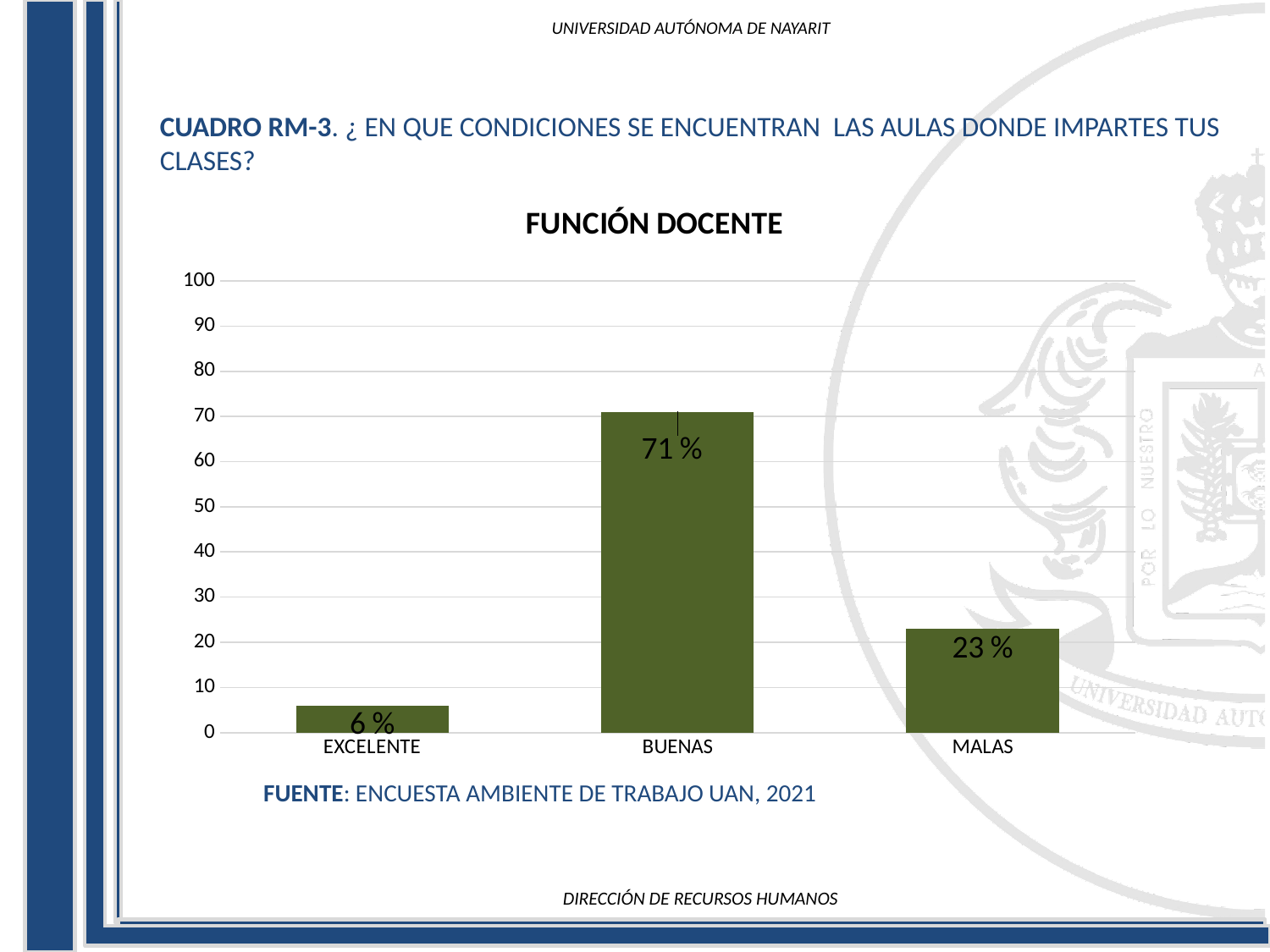
Is the value for BUENAS greater or less than 50? greater What is the difference between the values for BUENAS and MALAS? 48 % What is the value for MALAS? 23 % Which category has the lowest value? EXCELENTE What is the value for EXCELENTE? 6 % What is the value for BUENAS? 71 % Which is larger, the value for MALAS or the value for EXCELENTE? MALAS How many categories are shown on the x axis? 3 What is the difference between the values for MALAS and EXCELENTE? 17 % What kind of chart is shown on the slide? bar chart What is the title of the chart? FUNCIÓN DOCENTE Which category has the highest value? BUENAS